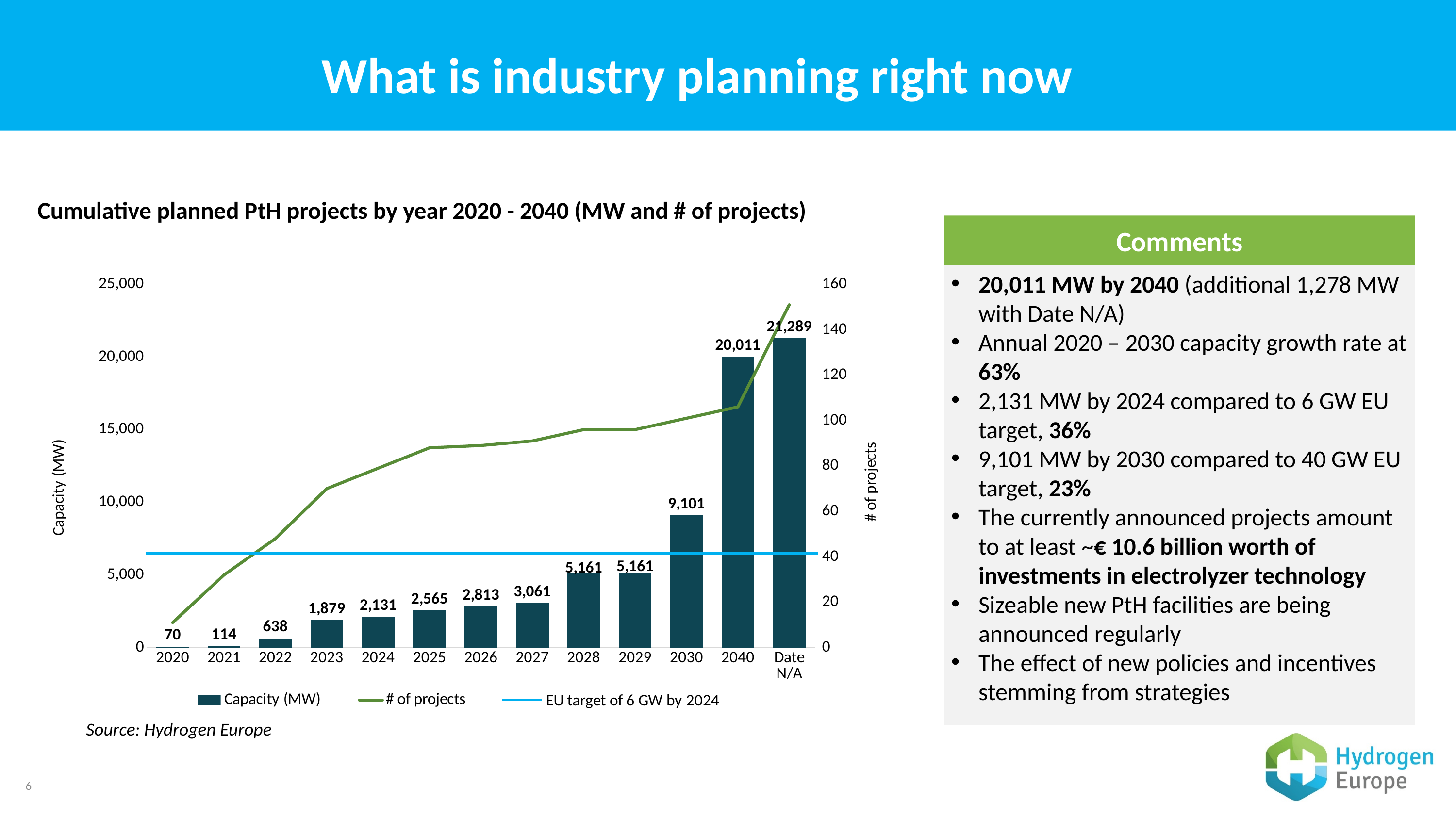
Is the # of projects value for 2020 greater or less than 20? less Does the Capacity (MW) rise or fall from 2020 to 2040? Rise Which has the larger Capacity (MW), 2027 or 2028? 2028 What is the difference in Capacity (MW) between 2040 and 2030? 10,910 How many categories are shown on the x axis? 13 Which year has the lowest Capacity (MW) bar? 2020 How many series does the legend list? 3 What is the cumulative planned capacity (MW) for 2030? 9,101 Which category has the highest Capacity (MW) bar? Date N/A How much higher is the Capacity (MW) for Date N/A than for 2040? 1,278 What is the cumulative planned capacity (MW) for 2024? 2,131 What kind of chart is shown on the slide? Combination bar and line chart